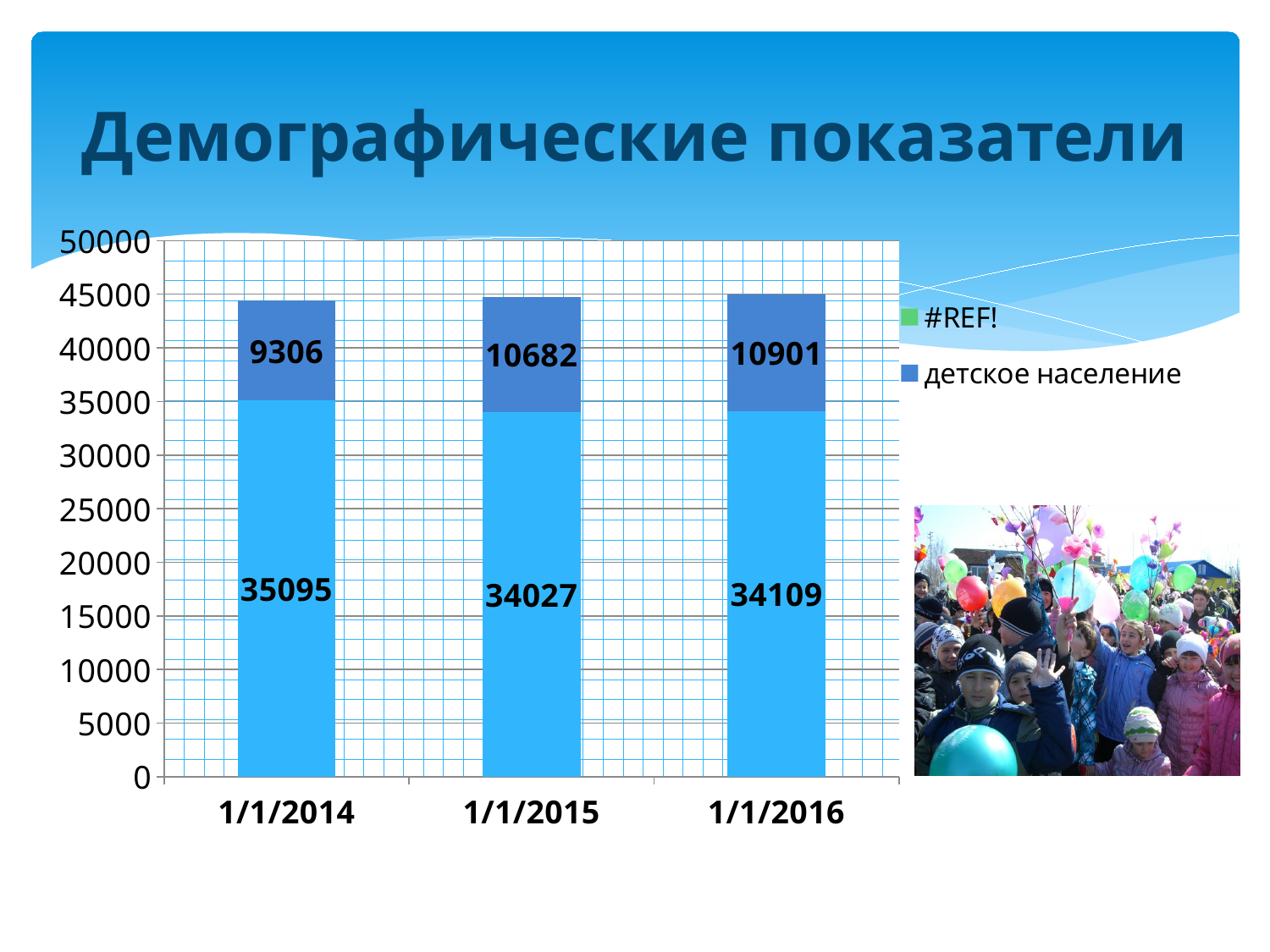
What kind of chart is shown on the slide? Stacked bar chart What is the difference between the top (dark blue) segment values for 1/1/2016 and 1/1/2014? 1595 Which date has the lowest value in the bottom (light blue) segment? 1/1/2015 What is the difference between the bottom (light blue) segment values for 1/1/2014 and 1/1/2015? 1068 What is the value of the top (dark blue) segment of the bar for 1/1/2015? 10682 How many dates are shown on the x axis of the chart? 3 What is the value of the bottom (light blue) segment of the bar for 1/1/2014? 35095 What is the value of the top (dark blue) segment of the bar for 1/1/2016? 10901 Which date has the highest value in the top (dark blue) segment? 1/1/2016 Which has a larger bottom (light blue) segment value, 1/1/2014 or 1/1/2015? 1/1/2014 How many entries does the chart legend list? 2 What is the total of the stacked bar for 1/1/2014? 44401